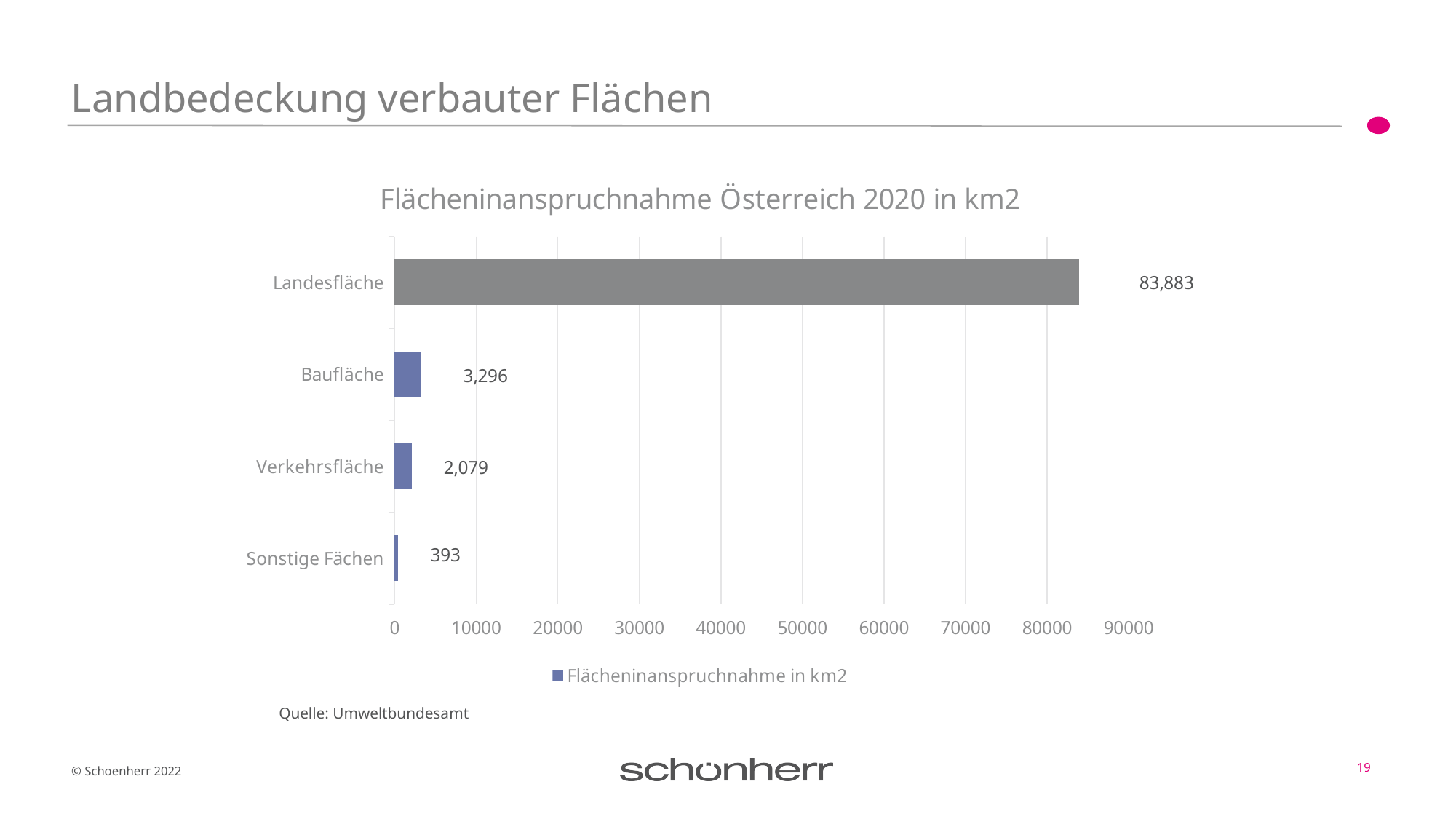
Is the value for Landesfläche greater or less than 80000? greater How many categories are shown in the chart? 4 What is the value for Landesfläche? 83,883 What is the title of the chart? Flächeninanspruchnahme Österreich 2020 in km2 What is the value for Verkehrsfläche? 2,079 What kind of chart is shown? Bar chart Which category has the highest value? Landesfläche What is the value for Baufläche? 3,296 Which category has the lowest value? Sonstige Fächen What is the difference between Baufläche and Verkehrsfläche? 1,217 What is the value for Sonstige Fächen? 393 Which is larger, Verkehrsfläche or Sonstige Fächen? Verkehrsfläche